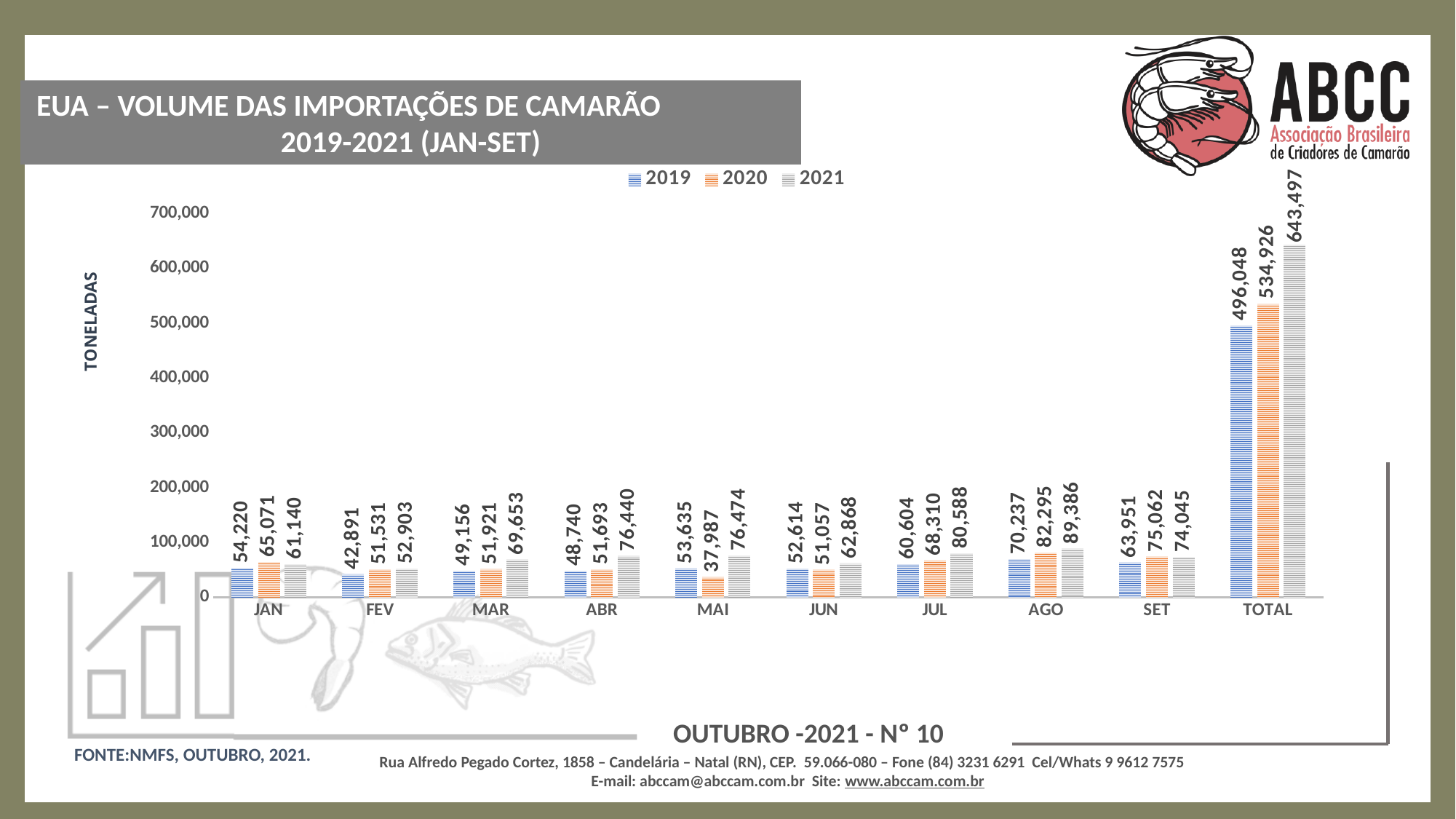
What is the 2020 value for TOTAL? 534,926 Which month has the lowest 2020 value? MAI What is the 2019 value for AGO? 70,237 What is the 2021 value for MAI? 76,474 What kind of chart is shown on the slide? bar chart For SET, which is larger: the 2020 value or the 2021 value? 2020 Which year has the highest TOTAL value? 2021 What is the difference between the 2021 TOTAL and the 2019 TOTAL? 147,449 Is the 2021 TOTAL value greater or less than 600,000? greater How many categories are shown on the x axis? 10 What is the difference between the 2020 and 2019 values for AGO? 12,058 How many series does the legend list? 3